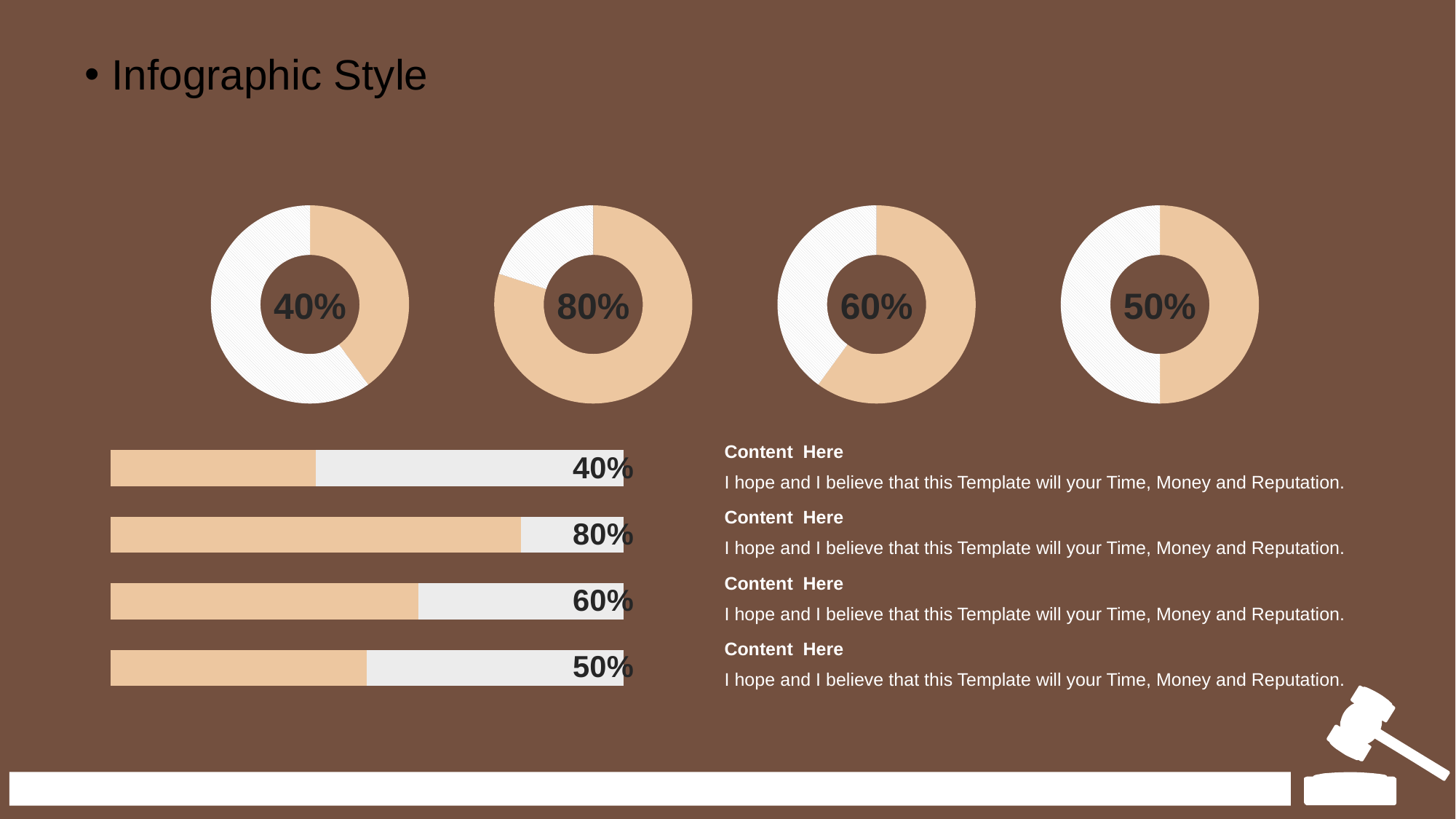
What value is labelled on the second horizontal bar from the top in the bar chart at the bottom left? 80% Which donut chart shows the lowest percentage? The leftmost (40%) What value is shown in the rightmost donut chart? 50% Which is larger: the value of the third donut chart or the fourth donut chart? The third donut chart (60%) What is the difference between the value of the second donut chart (80%) and the first donut chart (40%)? 40% How many donut charts are shown on the slide? 4 What kind of chart is shown at the bottom left of the slide? Bar chart What value is shown in the third donut chart from the left? 60% What value is shown in the second donut chart from the left? 80% What value is shown in the first (leftmost) donut chart? 40% Which donut chart shows the highest percentage? The second from the left (80%) What value is labelled on the bottom horizontal bar in the bar chart at the bottom left? 50%